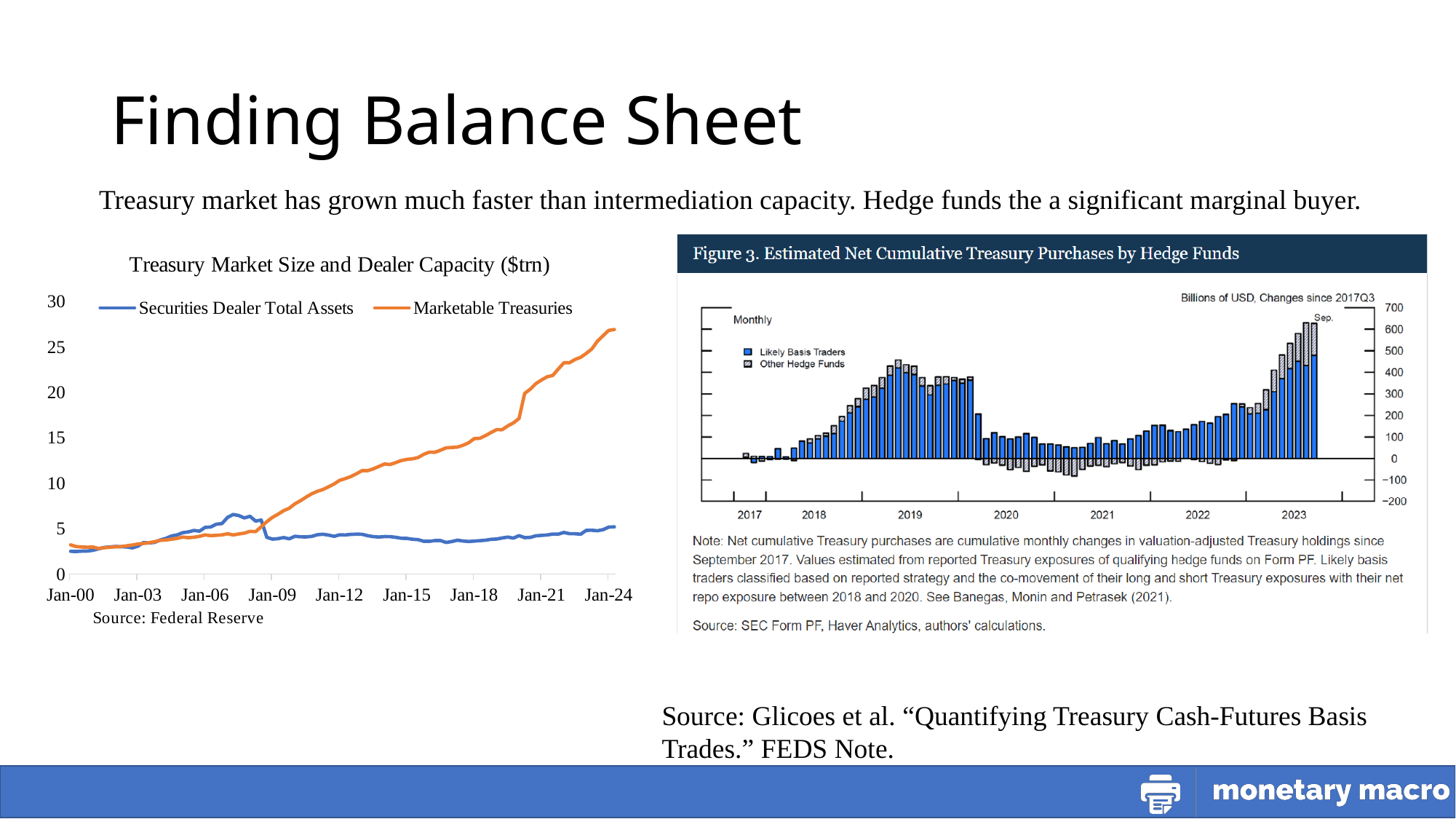
In the 'Treasury Market Size and Dealer Capacity ($trn)' chart, is the value of Securities Dealer Total Assets at Jan-24 greater or less than 10? less In 'Figure 3. Estimated Net Cumulative Treasury Purchases by Hedge Funds', is the total of the last bar (Sep. 2023) greater or less than 600? greater In the 'Treasury Market Size and Dealer Capacity ($trn)' chart, is the value of Marketable Treasuries at Jan-24 greater or less than 25? greater How many series does the legend of the 'Treasury Market Size and Dealer Capacity ($trn)' chart list? 2 What kind of chart is 'Figure 3. Estimated Net Cumulative Treasury Purchases by Hedge Funds'? bar chart In the 'Treasury Market Size and Dealer Capacity ($trn)' chart, does the Marketable Treasuries series rise or fall from Jan-00 to Jan-24? rise In the 'Treasury Market Size and Dealer Capacity ($trn)' chart, which series is higher at Jan-24, Securities Dealer Total Assets or Marketable Treasuries? Marketable Treasuries How many series does the legend of 'Figure 3. Estimated Net Cumulative Treasury Purchases by Hedge Funds' list? 2 What kind of chart is the 'Treasury Market Size and Dealer Capacity ($trn)' chart? line chart What source is cited below the 'Treasury Market Size and Dealer Capacity ($trn)' chart? Federal Reserve In 'Figure 3. Estimated Net Cumulative Treasury Purchases by Hedge Funds', what unit is shown for the values? Billions of USD, Changes since 2017Q3